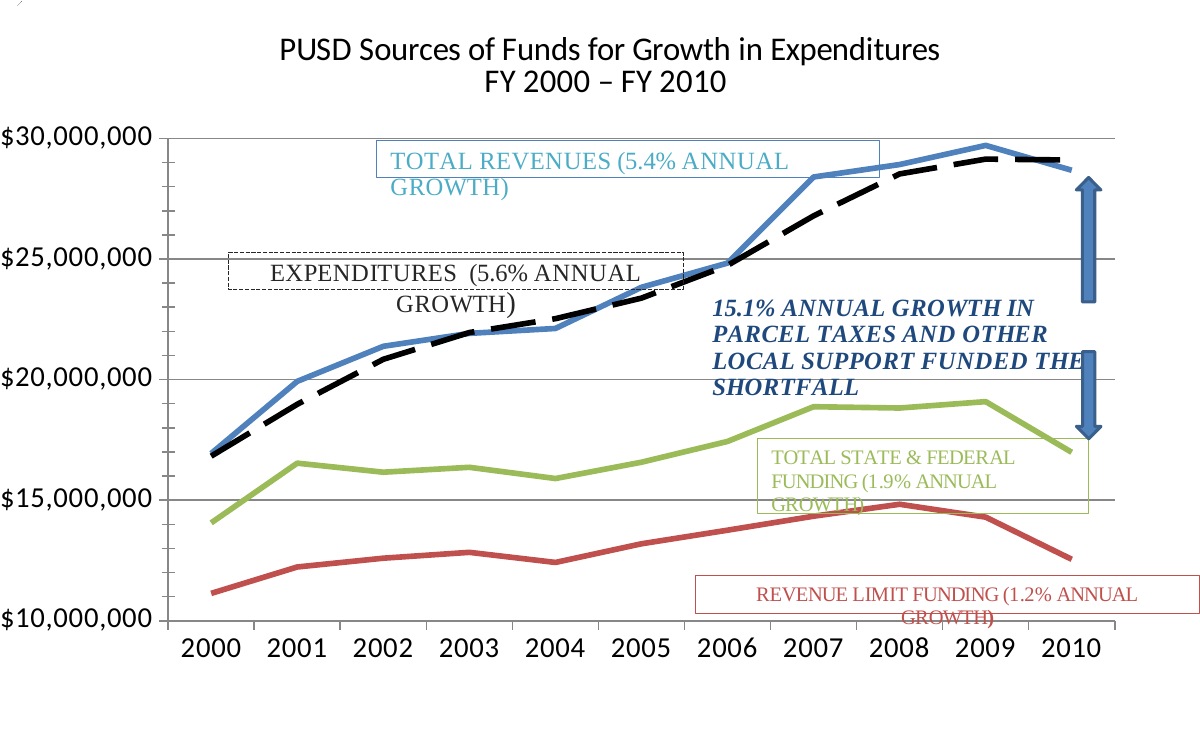
In 2005, which is higher: Total State & Federal Funding or Revenue Limit Funding? Total State & Federal Funding How many years are plotted along the x axis? 11 In which year is Revenue Limit Funding at its lowest? 2000 Does Revenue Limit Funding rise or fall from 2009 to 2010? fall What is the title of the chart? PUSD Sources of Funds for Growth in Expenditures FY 2000 – FY 2010 Is the value for Total Revenues in 2009 greater or less than $25,000,000? greater What kind of chart is shown on the slide? line chart Is the value for Total State & Federal Funding in 2009 greater or less than $20,000,000? less What annual growth rate is given for Total Revenues? 5.4% Is the value for Total Revenues in 2000 greater or less than $20,000,000? less In which year does the Total Revenues line reach its highest value? 2009